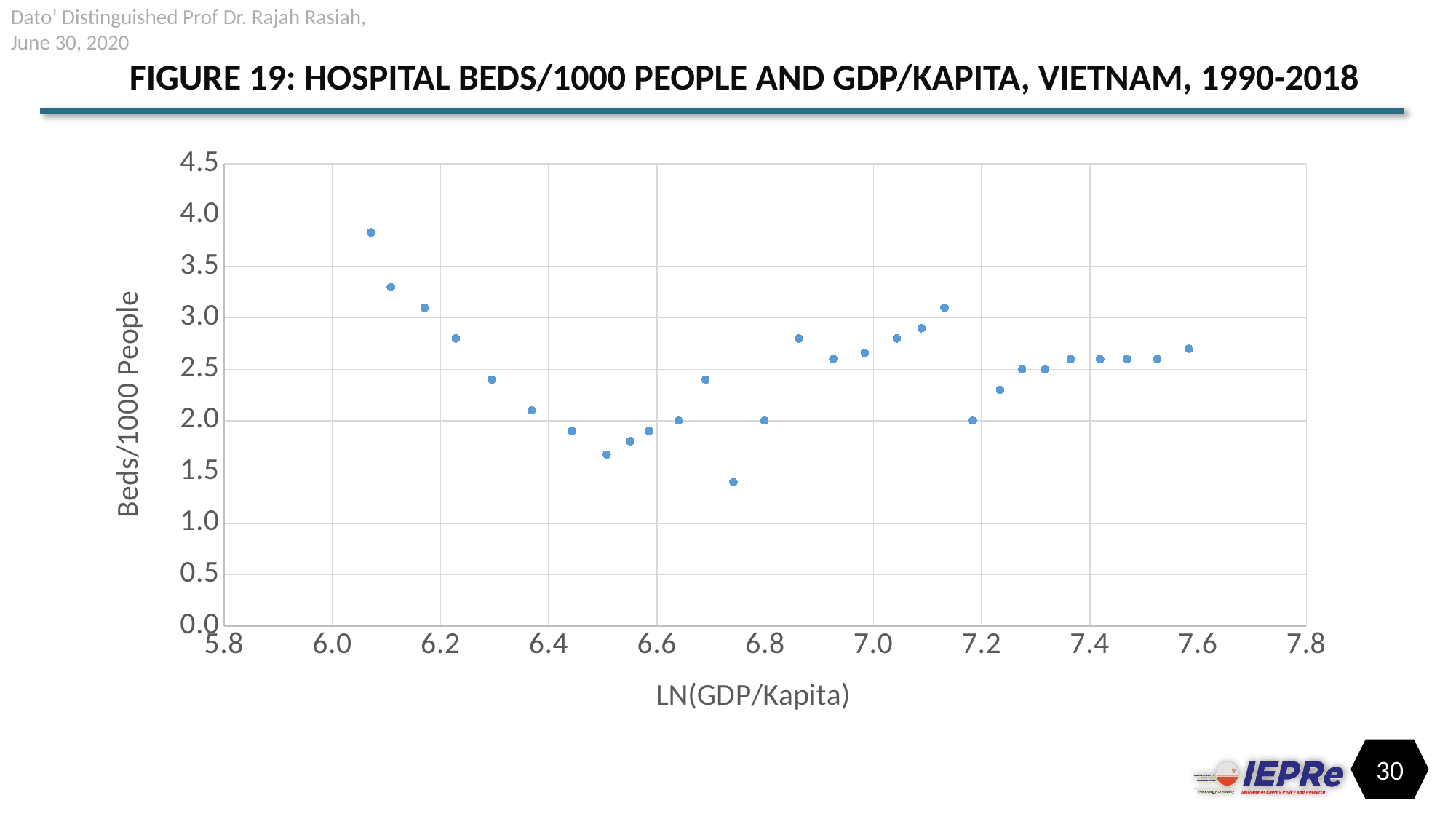
What is the label of the vertical axis? Beds/1000 People Which point has the highest Beds/1000 People value: the leftmost point or the rightmost point? The leftmost point Do the Beds/1000 People values rise or fall as LN(GDP/Kapita) increases from 6.0 to 6.5? Fall What kind of chart is shown on the slide? Scatter chart Is the value for the rightmost point (highest LN(GDP/Kapita)) greater or less than 2.5 beds per 1000 people? greater What is the maximum value shown on the vertical axis? 4.5 Is the lowest point on the chart greater or less than 1.5 beds per 1000 people? less Is the value for the point at LN(GDP/Kapita) of about 7.2 greater or less than 2.5 beds per 1000 people? less Do the Beds/1000 People values rise or fall as LN(GDP/Kapita) increases from 7.2 to 7.6? Rise How many data points are plotted on the chart? 29 What is the title of the chart? FIGURE 19: HOSPITAL BEDS/1000 PEOPLE AND GDP/KAPITA, VIETNAM, 1990-2018